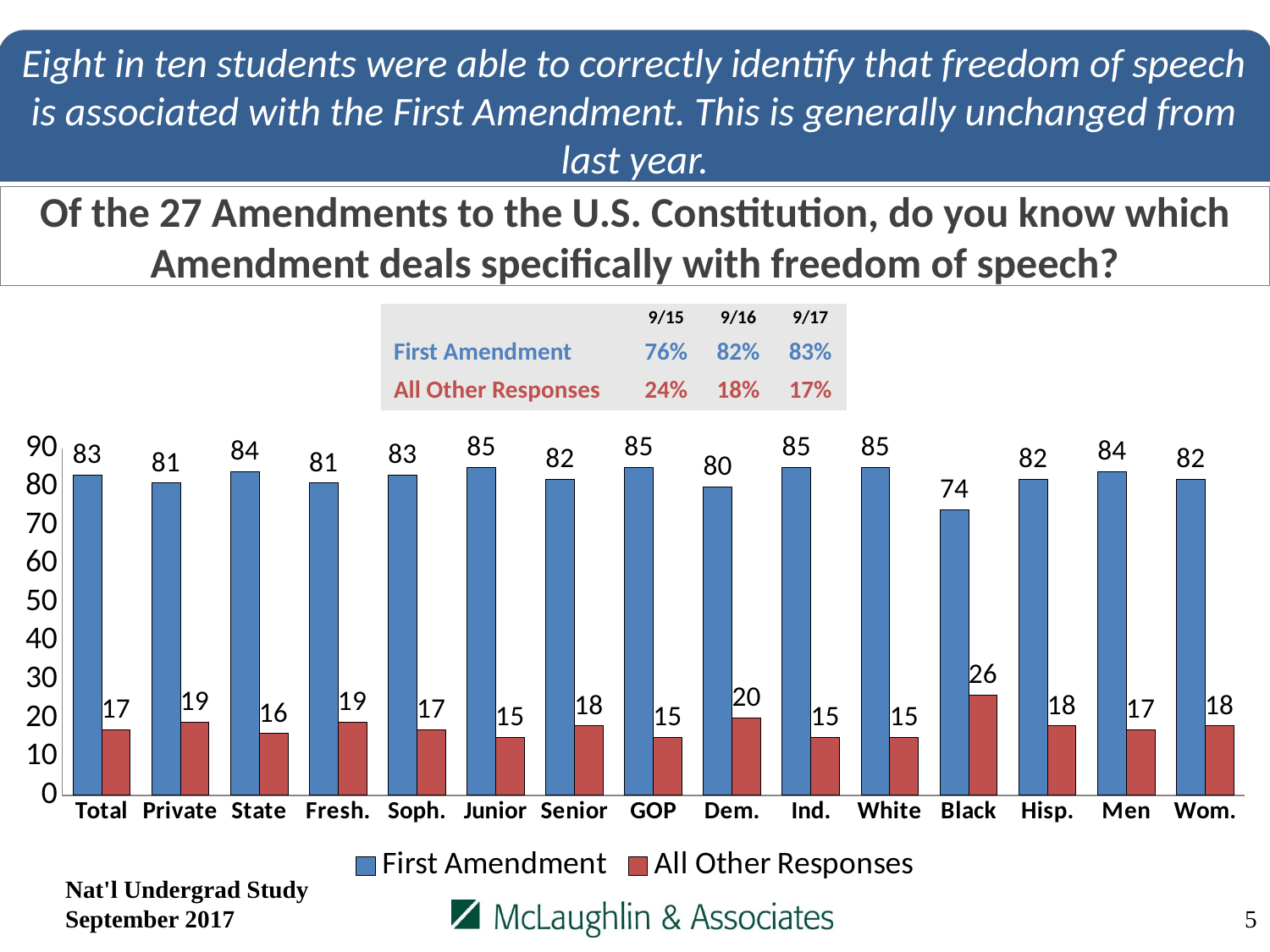
What is the All Other Responses value for Dem.? 20 Which category has the lowest First Amendment value? Black How many series does the legend list? 2 Is the First Amendment value for Dem. greater or less than 70? greater How many categories are shown on the x axis of the bar chart? 15 Which category has the highest All Other Responses value? Black What is the difference between the First Amendment values for White and Black? 11 What kind of chart is shown on the slide? bar chart What is the First Amendment value for Total? 83 What is the First Amendment value for Black? 74 Which is larger, the First Amendment value for Men or for Wom.? Men In the table above the chart, what is the First Amendment value for 9/17? 83%